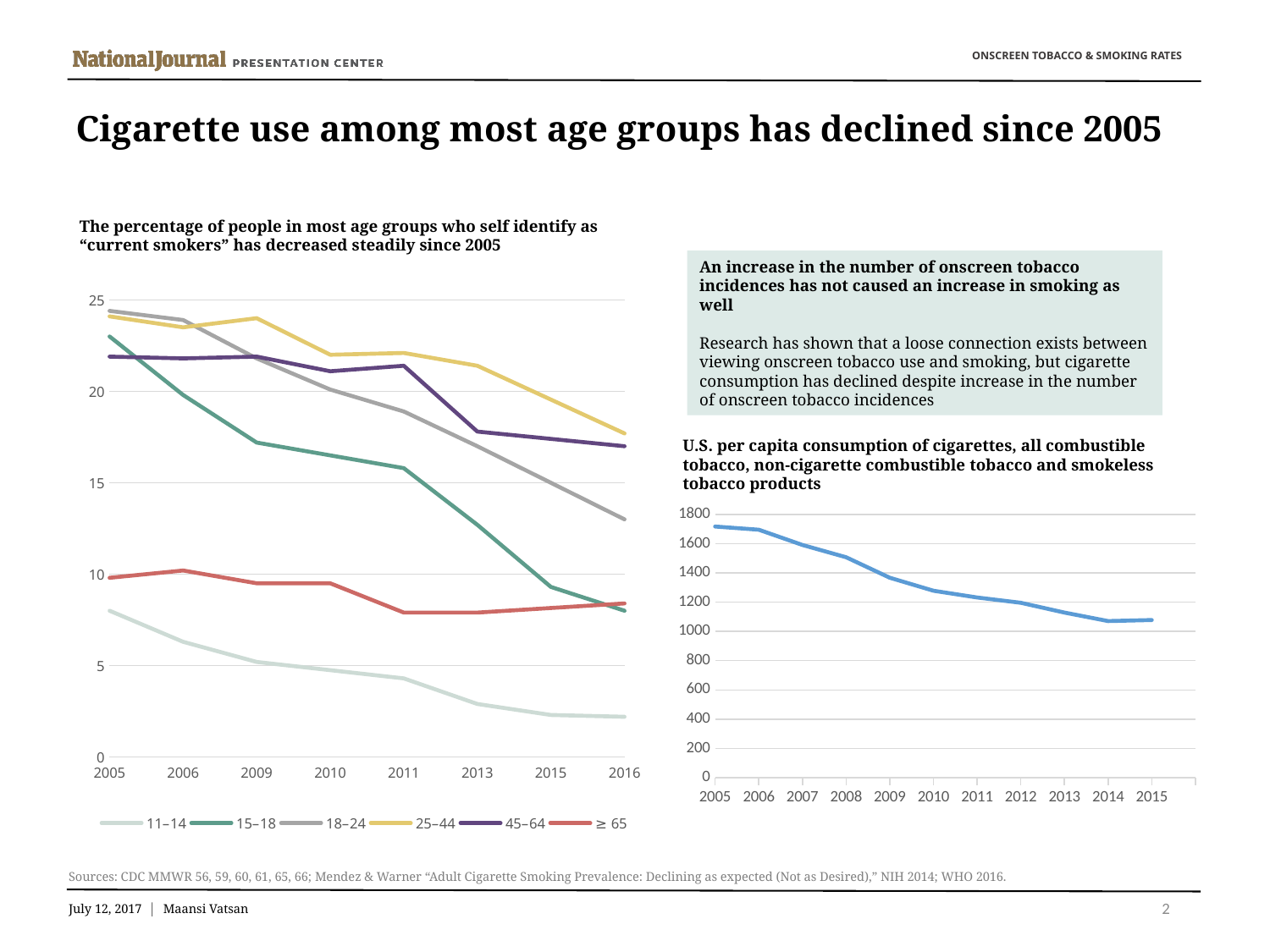
How many series does the legend of the left chart (percentage of current smokers by age group) list? 6 In the right chart (U.S. per capita consumption of cigarettes and tobacco products), does the line rise or fall from 2005 to 2015? fall In the left chart (percentage of current smokers by age group), is the value for 15–18 in 2005 greater or less than 20? greater In the left chart (percentage of current smokers by age group), does the 15–18 line rise or fall from 2005 to 2016? fall In the left chart (percentage of current smokers by age group), which age group has the lowest value in 2005? 11–14 In the left chart (percentage of current smokers by age group), which age group has the lowest value in 2016? 11–14 In the left chart (percentage of current smokers by age group), which is larger in 2009: the value for 15–18 or the value for 11–14? 15–18 In the left chart (percentage of current smokers by age group), is the value for 18–24 in 2016 greater or less than 15? less How many years are shown on the x axis of the left chart (percentage of current smokers by age group)? 8 What kind of chart is the left chart, 'The percentage of people in most age groups who self identify as "current smokers"'? line chart How many years are shown on the x axis of the right chart (U.S. per capita consumption of cigarettes and tobacco products)? 11 In the right chart (U.S. per capita consumption of cigarettes and tobacco products), is the value for 2005 greater or less than 1600? greater